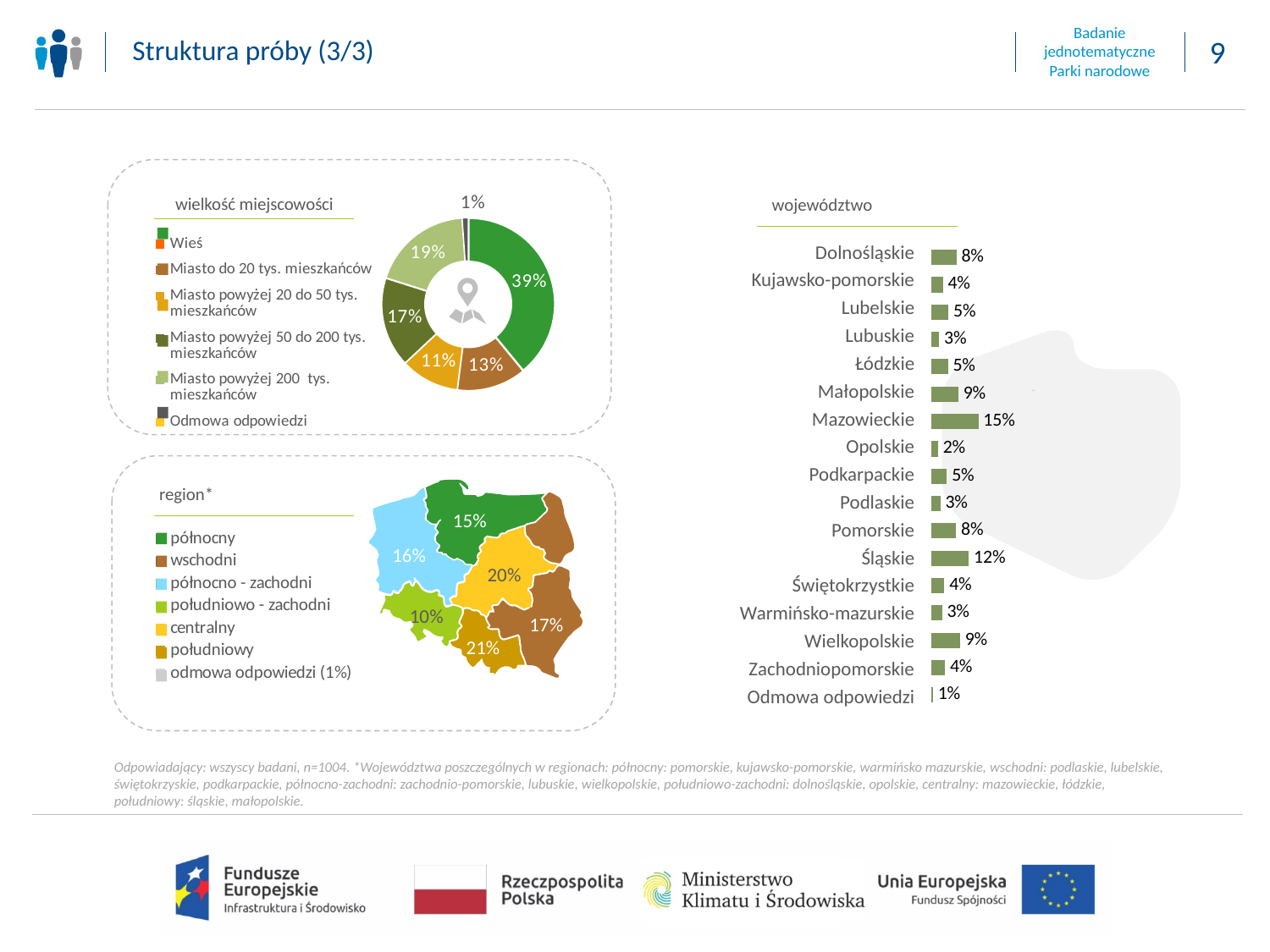
In the 'województwo' bar chart, which voivodeship has the highest value? Mazowieckie In the 'województwo' bar chart, which is larger: the value for Małopolskie or the value for Lubelskie? Małopolskie In the 'region*' map chart, what is the value for the 'południowy' region? 21% In the 'województwo' bar chart, which voivodeship has the lowest value (excluding 'Odmowa odpowiedzi')? Opolskie In the 'wielkość miejscowości' doughnut chart, what is the share for 'Wieś'? 39% How many entries does the legend of the 'wielkość miejscowości' chart list? 6 In the 'województwo' bar chart, what is the value for Mazowieckie? 15% In the 'wielkość miejscowości' doughnut chart, what is the difference between the shares for 'Miasto powyżej 200 tys. mieszkańców' and 'Miasto powyżej 50 do 200 tys. mieszkańców'? 2% What kind of chart is the 'województwo' chart? bar chart In the 'wielkość miejscowości' doughnut chart, which category has the largest share? Wieś In the 'województwo' bar chart, what is the difference between the values for Śląskie and Dolnośląskie? 4% How many categories (bars) are shown in the 'województwo' bar chart? 17